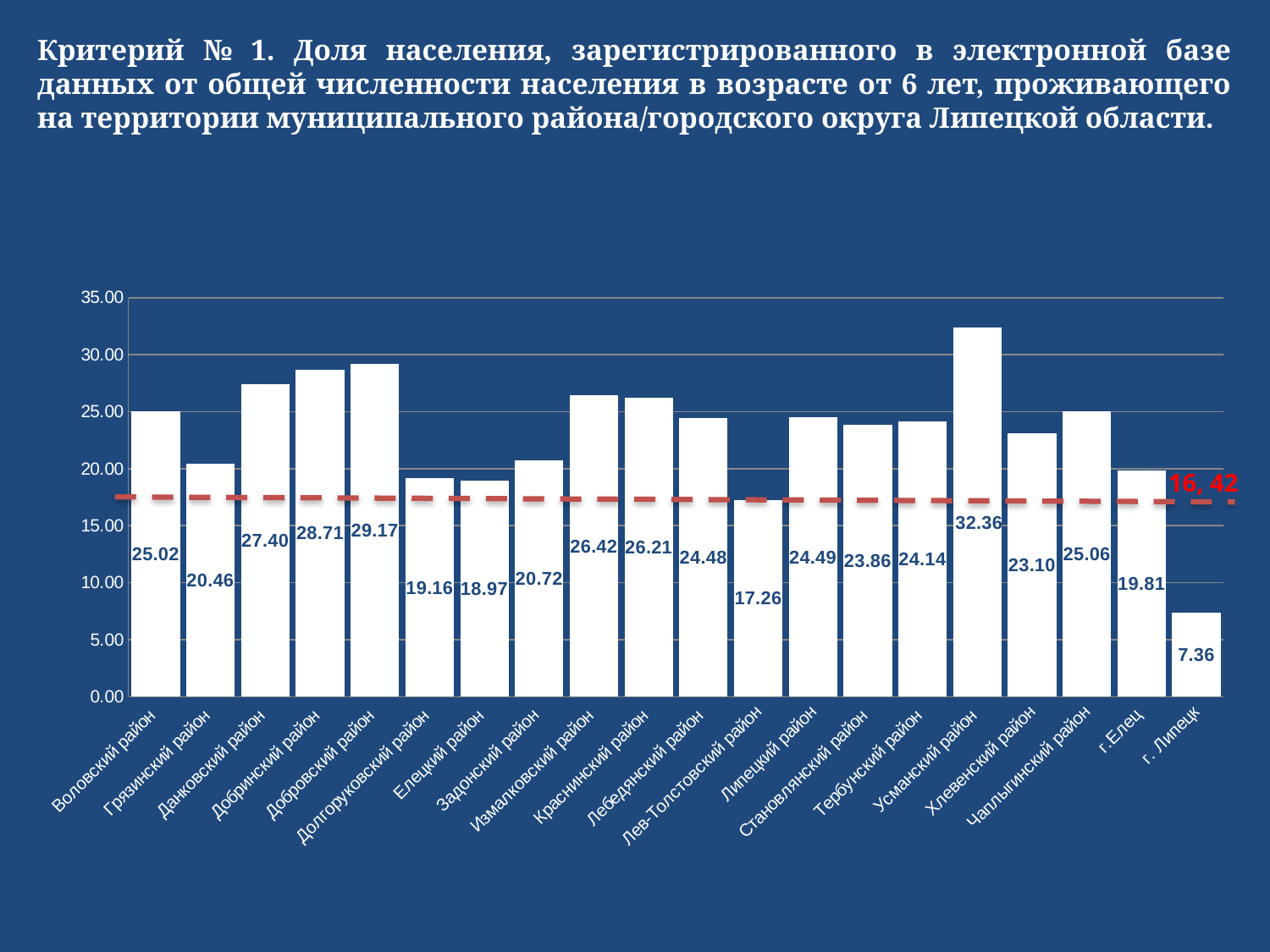
What is the value for г. Липецк? 7.36 What value is labelled on the red dashed horizontal line? 16, 42 Which category has the lowest value? г. Липецк Is the value for Усманский район greater or less than 30.00? greater How many categories are shown on the x axis? 20 Which category has the highest value? Усманский район Which is larger, the value for Воловский район or the value for Грязинский район? Воловский район What is the value for Лев-Толстовский район? 17.26 What kind of chart is shown on the slide? bar chart What is the value for Усманский район? 32.36 What is the difference between the values for Добровский район and Данковский район? 1.77 What is the difference between the values for Усманский район and г. Липецк? 25.00